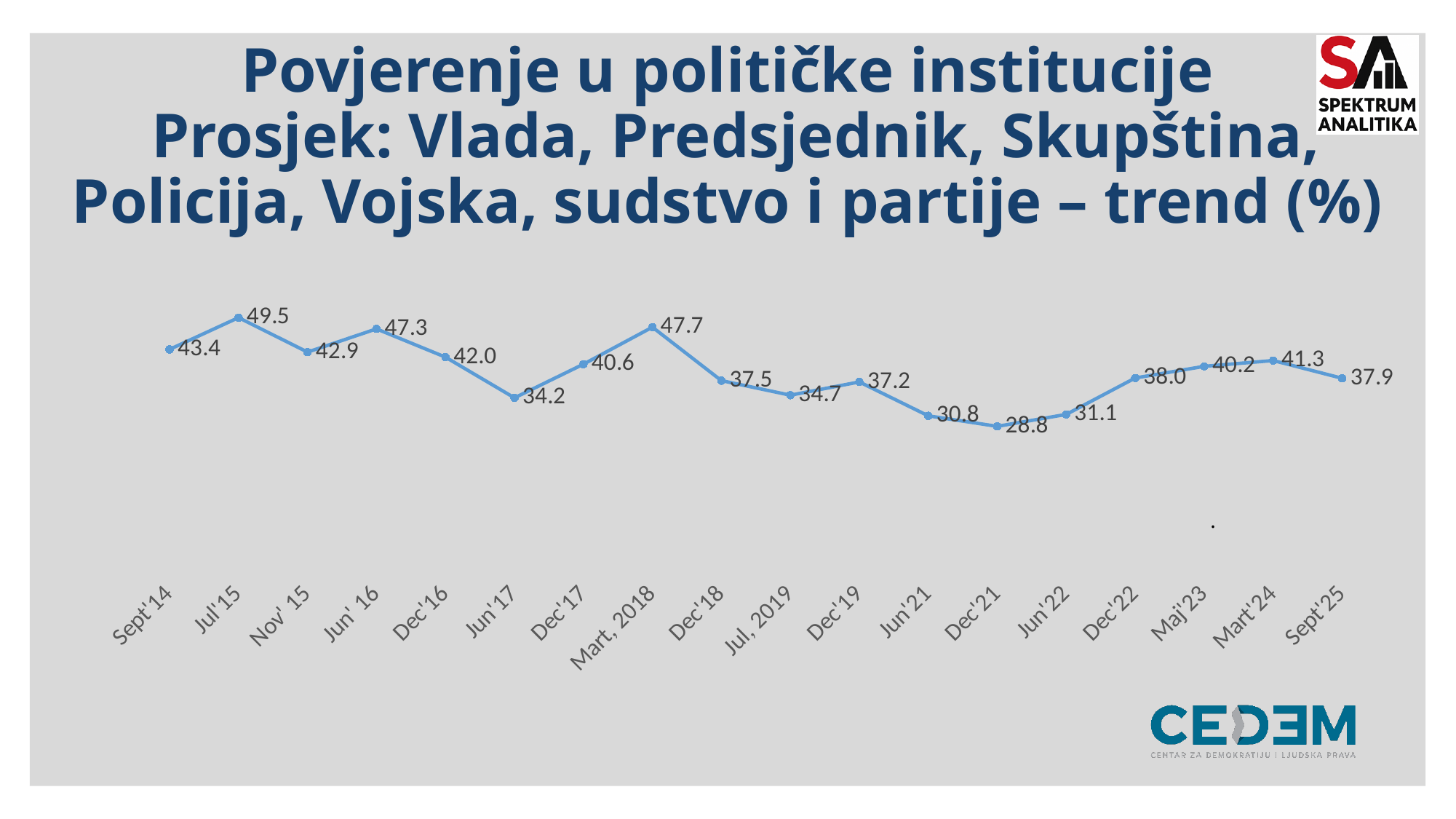
Do the values rise or fall from Dec'21 to Mart'24? Rise What is the difference between the values for Jul'15 and Sept'14? 6.1 What is the value for Sept'14? 43.4 What is the value for Mart, 2018? 47.7 What is the difference between the values for Mart'24 and Sept'25? 3.4 How many data points are plotted on the chart? 18 What kind of chart is shown on the slide? Line chart What is the value for Sept'25? 37.9 Which period has the highest value? Jul'15 What is the value for Dec'21? 28.8 Which is larger, the value for Jun' 16 or the value for Dec'16? Jun' 16 Which period has the lowest value? Dec'21